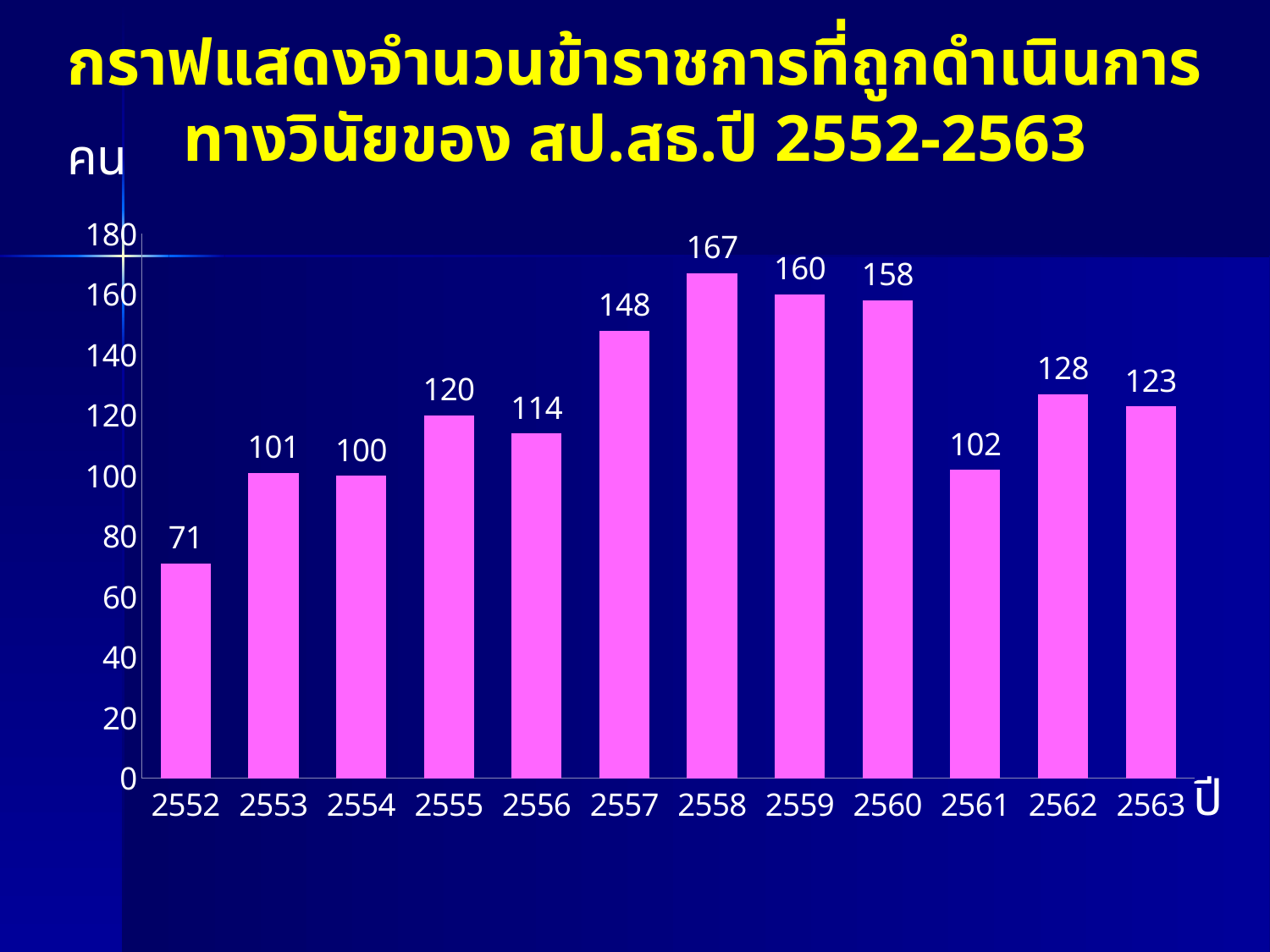
Which is larger, the value for 2557 or the value for 2560? 2560 What kind of chart is shown on the slide? bar chart What is the value for 2561? 102 What colour are the bars in the chart? pink What is the value for 2552? 71 Which year has the highest value? 2558 Which year has the lowest value? 2552 What is the difference between the values for 2562 and 2563? 5 What is the difference between the values for 2558 and 2552? 96 How many years are shown on the x axis? 12 What is the value for 2558? 167 Is the value for 2559 greater or less than 140? greater